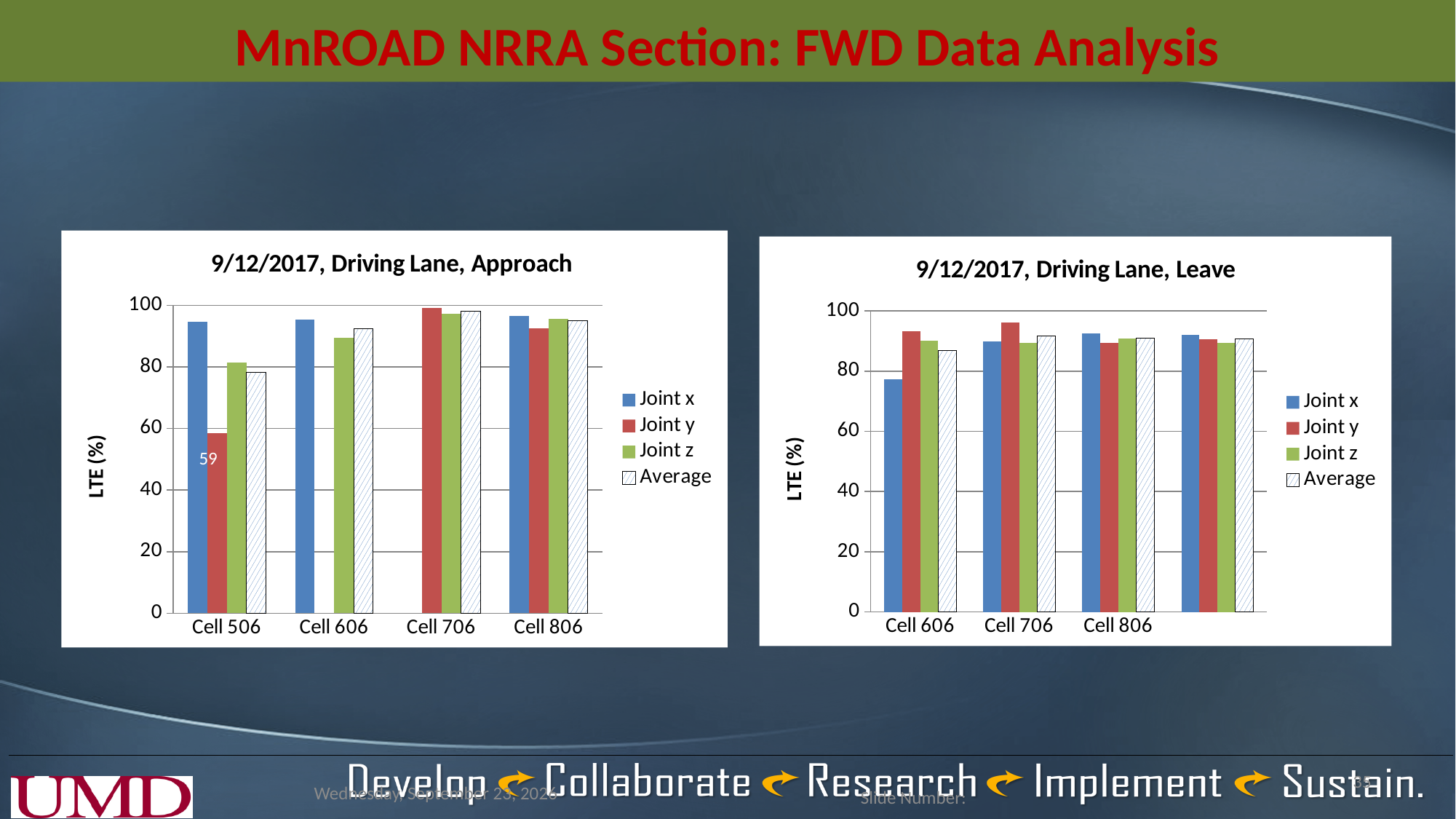
In the '9/12/2017, Driving Lane, Approach' chart, which cell has the lowest Joint y value? Cell 506 How many series does the legend of the '9/12/2017, Driving Lane, Leave' chart list? 4 In the '9/12/2017, Driving Lane, Approach' chart, is the Joint x value for Cell 506 greater or less than 80? greater How many cells are shown on the x axis of the '9/12/2017, Driving Lane, Approach' chart? 4 In the '9/12/2017, Driving Lane, Leave' chart, is the Joint x value for Cell 606 greater or less than 80? less What is the y-axis label of the '9/12/2017, Driving Lane, Approach' chart? LTE (%) In the '9/12/2017, Driving Lane, Leave' chart, which cell has the lowest Joint x value? Cell 606 In the '9/12/2017, Driving Lane, Leave' chart, which series has the highest value at Cell 606? Joint y What kind of chart is the '9/12/2017, Driving Lane, Approach' chart? Bar chart In the '9/12/2017, Driving Lane, Approach' chart, at Cell 506, which is larger: Joint x or Joint y? Joint x How many cells are shown on the x axis of the '9/12/2017, Driving Lane, Leave' chart? 3 In the '9/12/2017, Driving Lane, Approach' chart, what is the LTE (%) value for Joint y at Cell 506? 59